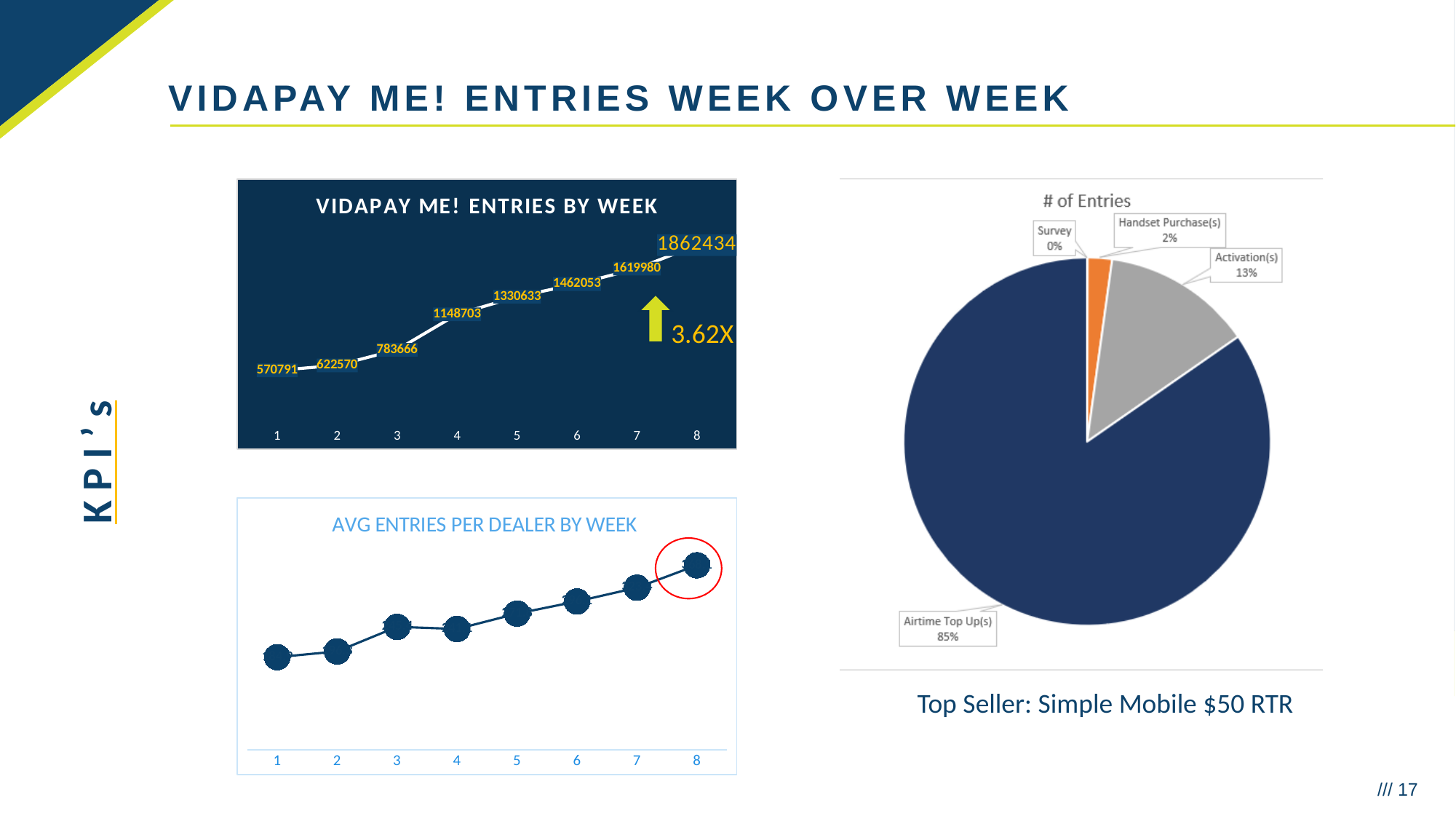
In the "VIDAPAY ME! ENTRIES BY WEEK" chart, which week has the lowest value? 1 In the "VIDAPAY ME! ENTRIES BY WEEK" chart, what is the value for week 8? 1862434 In the "VIDAPAY ME! ENTRIES BY WEEK" chart, do the values rise or fall from week 1 to week 8? rise In the "VIDAPAY ME! ENTRIES BY WEEK" chart, what is the value for week 1? 570791 In the "VIDAPAY ME! ENTRIES BY WEEK" chart, what is the value for week 5? 1330633 In the "VIDAPAY ME! ENTRIES BY WEEK" chart, which week has the highest value? 8 In the "# of Entries" pie chart, what share does Activation(s) have? 13% In the "# of Entries" pie chart, what share does Airtime Top Up(s) have? 85% In the "VIDAPAY ME! ENTRIES BY WEEK" chart, what is the difference between the values for week 8 and week 1? 1291643 What kind of chart is "AVG ENTRIES PER DEALER BY WEEK"? line chart In the "AVG ENTRIES PER DEALER BY WEEK" chart, is the value for week 8 larger or smaller than the value for week 1? larger In the "VIDAPAY ME! ENTRIES BY WEEK" chart, how many weeks are plotted? 8